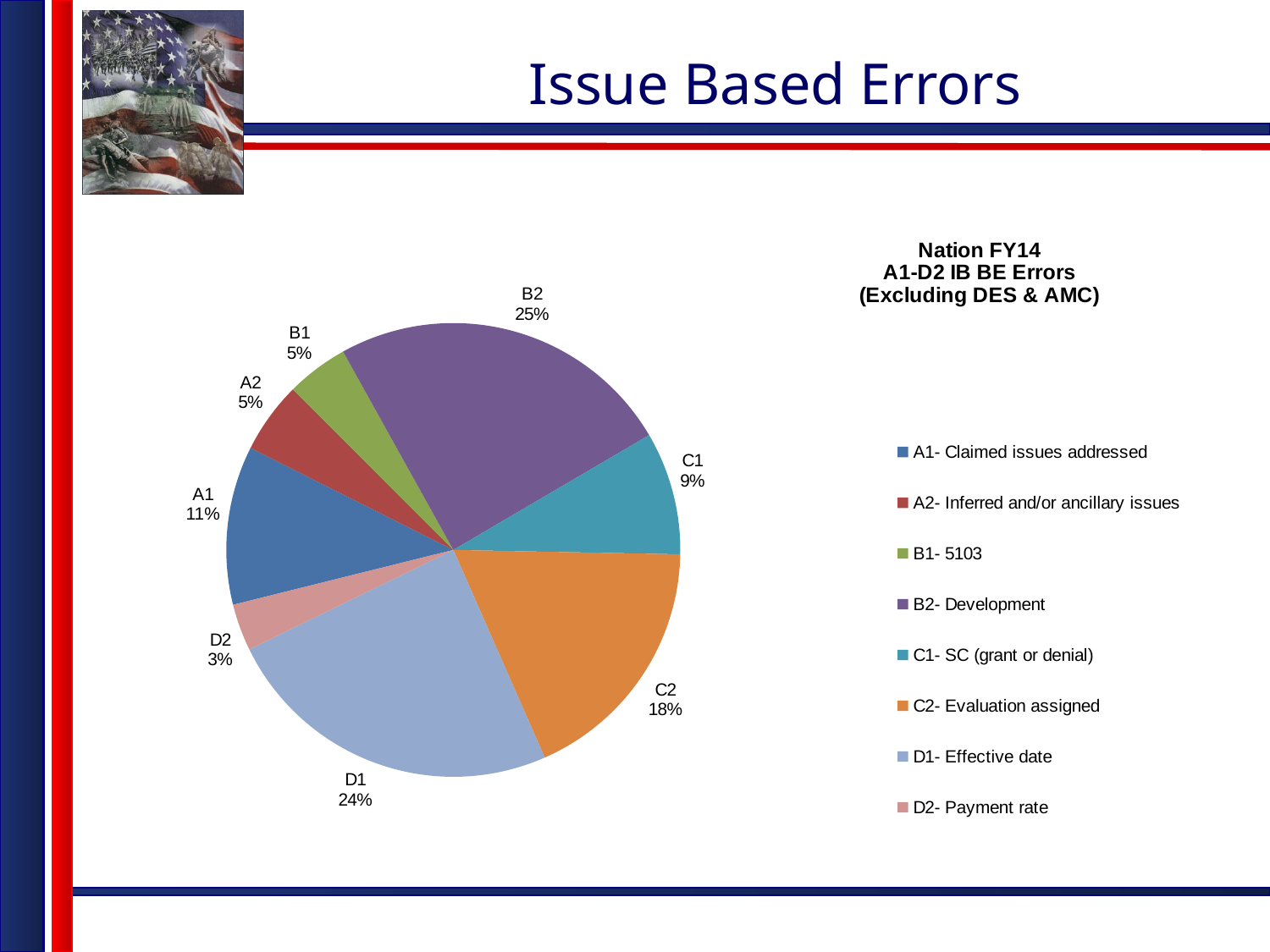
What is the difference in percentage points between C2 and C1? 9 Which category has the largest slice of the pie? B2 How many slices does the pie chart have? 8 What is the combined share of B1 and A2? 10% What is the value shown for D1 (Effective date)? 24% Which category has the smallest slice of the pie? D2 What kind of chart is shown on the slide? Pie chart What share of the pie does B2 (Development) represent? 25% What percentage is shown for C2 (Evaluation assigned)? 18% According to the legend, what does C1 stand for? SC (grant or denial) Which is larger, the slice for A1 or the slice for C1? A1 What is the title of the pie chart? Nation FY14 A1-D2 IB BE Errors (Excluding DES & AMC)